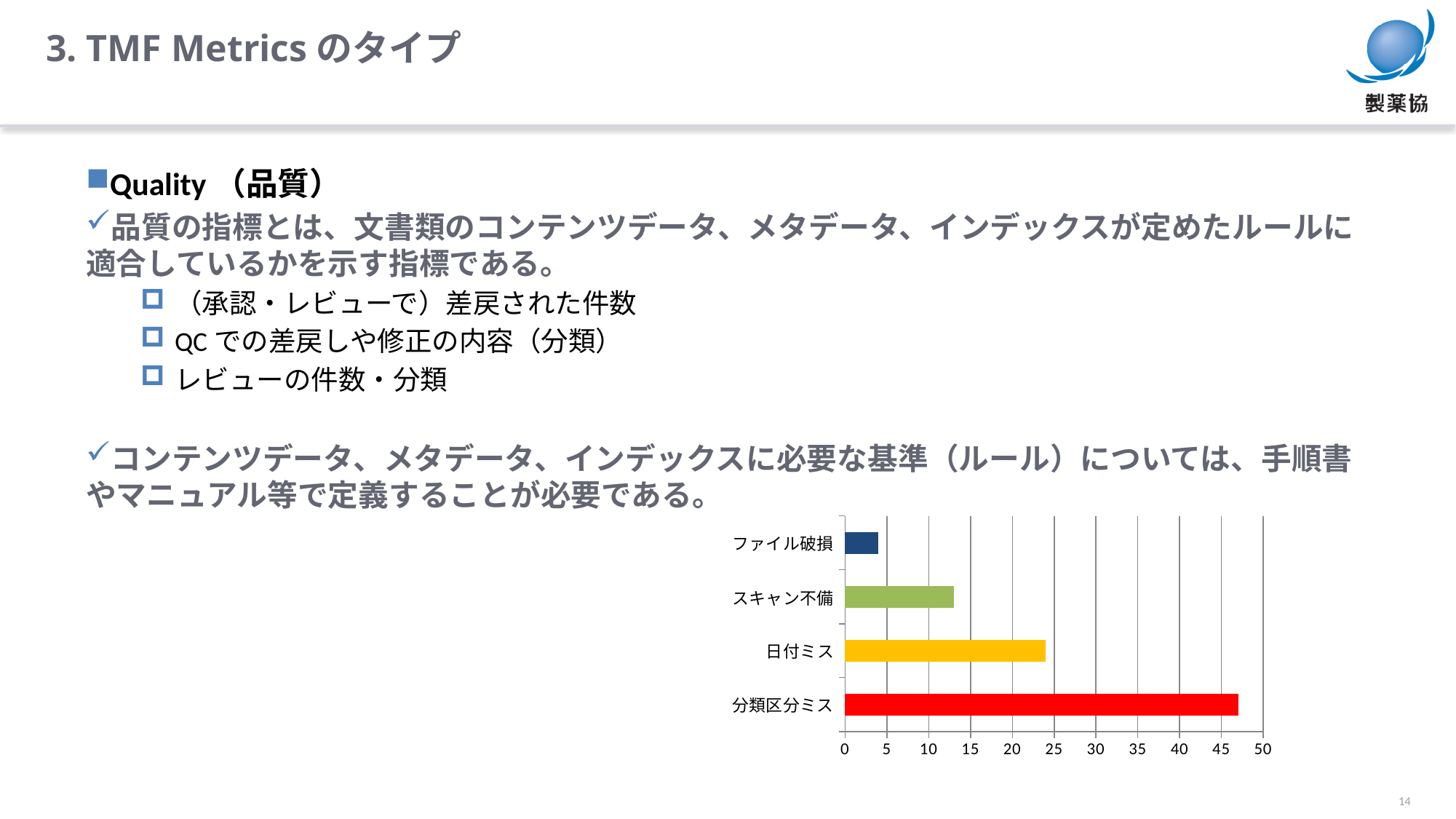
Which is larger, the value for 日付ミス or the value for スキャン不備? 日付ミス Which category has the lowest value in the bar chart? ファイル破損 Is the value for 日付ミス greater or less than 25? less Which category has the highest value in the bar chart? 分類区分ミス Is the value for スキャン不備 greater or less than 10? greater Is the value for 分類区分ミス greater or less than 45? greater What kind of chart is shown on the slide? bar chart How many categories are plotted in the bar chart? 4 Which is larger, the value for ファイル破損 or the value for スキャン不備? スキャン不備 What colour is the bar for 分類区分ミス? red What is the maximum value shown on the horizontal axis of the bar chart? 50